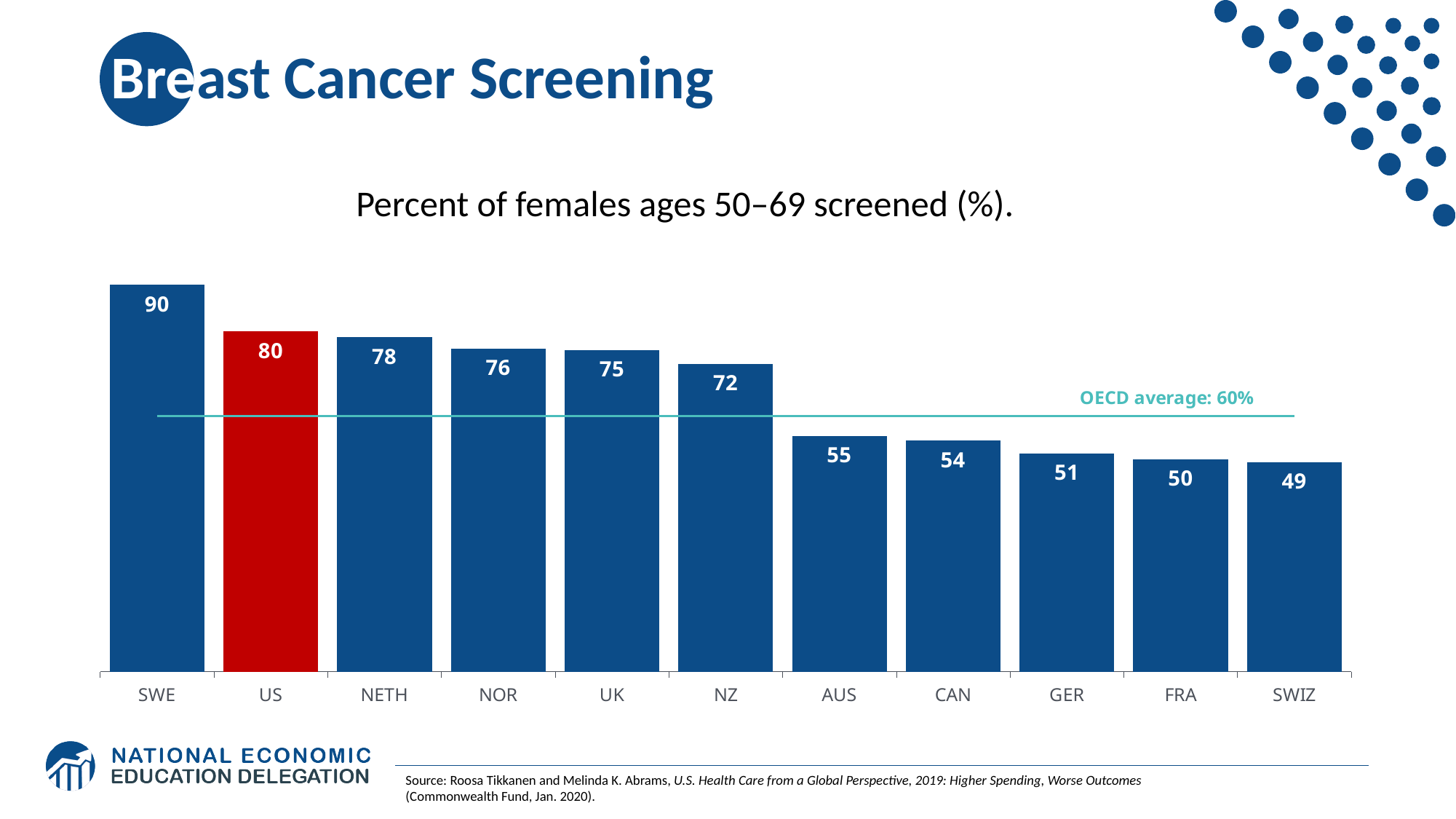
What is the difference between the values for SWE and the US? 10 What kind of chart is shown on the slide? Bar chart What is the value for NZ? 72 What is the difference between the values for NETH and AUS? 23 Which country has the highest value? SWE What OECD average is marked by the horizontal line on the chart? 60% How many countries are shown on the chart? 11 What is the value for the US? 80 Do the values rise or fall from left to right along the x axis? Fall Which country has the lowest value? SWIZ What is the value for FRA? 50 Which is larger, the value for NOR or the value for CAN? NOR